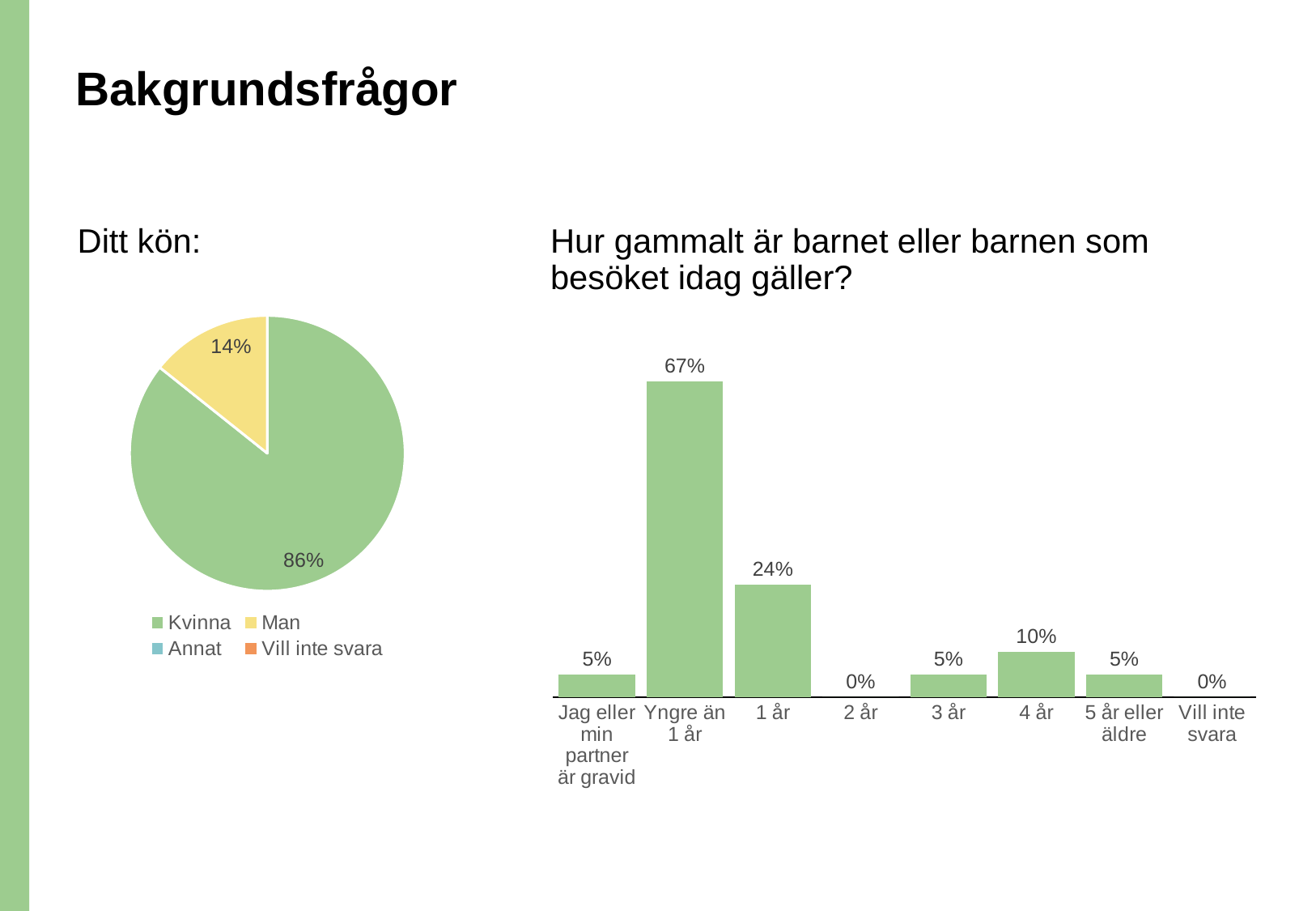
In the 'Hur gammalt är barnet eller barnen som besöket idag gäller?' chart, what is the value for '4 år'? 10% What kind of chart is the 'Ditt kön:' chart? Pie chart In the 'Hur gammalt är barnet eller barnen som besöket idag gäller?' chart, what is the value for '1 år'? 24% In the 'Ditt kön:' pie chart, what share is labelled for Man? 14% In the 'Hur gammalt är barnet eller barnen som besöket idag gäller?' chart, what is the difference between 'Yngre än 1 år' and '1 år'? 43% How many categories are shown in the 'Hur gammalt är barnet eller barnen som besöket idag gäller?' chart? 8 In the 'Ditt kön:' pie chart, what share is labelled for Kvinna? 86% In the 'Hur gammalt är barnet eller barnen som besöket idag gäller?' chart, which is larger: '4 år' or '3 år'? 4 år How many entries does the legend of the 'Ditt kön:' pie chart list? 4 In the 'Hur gammalt är barnet eller barnen som besöket idag gäller?' chart, what is the value for 'Yngre än 1 år'? 67% In the 'Hur gammalt är barnet eller barnen som besöket idag gäller?' chart, which category has the highest value? Yngre än 1 år What kind of chart is the 'Hur gammalt är barnet eller barnen som besöket idag gäller?' chart? Bar chart